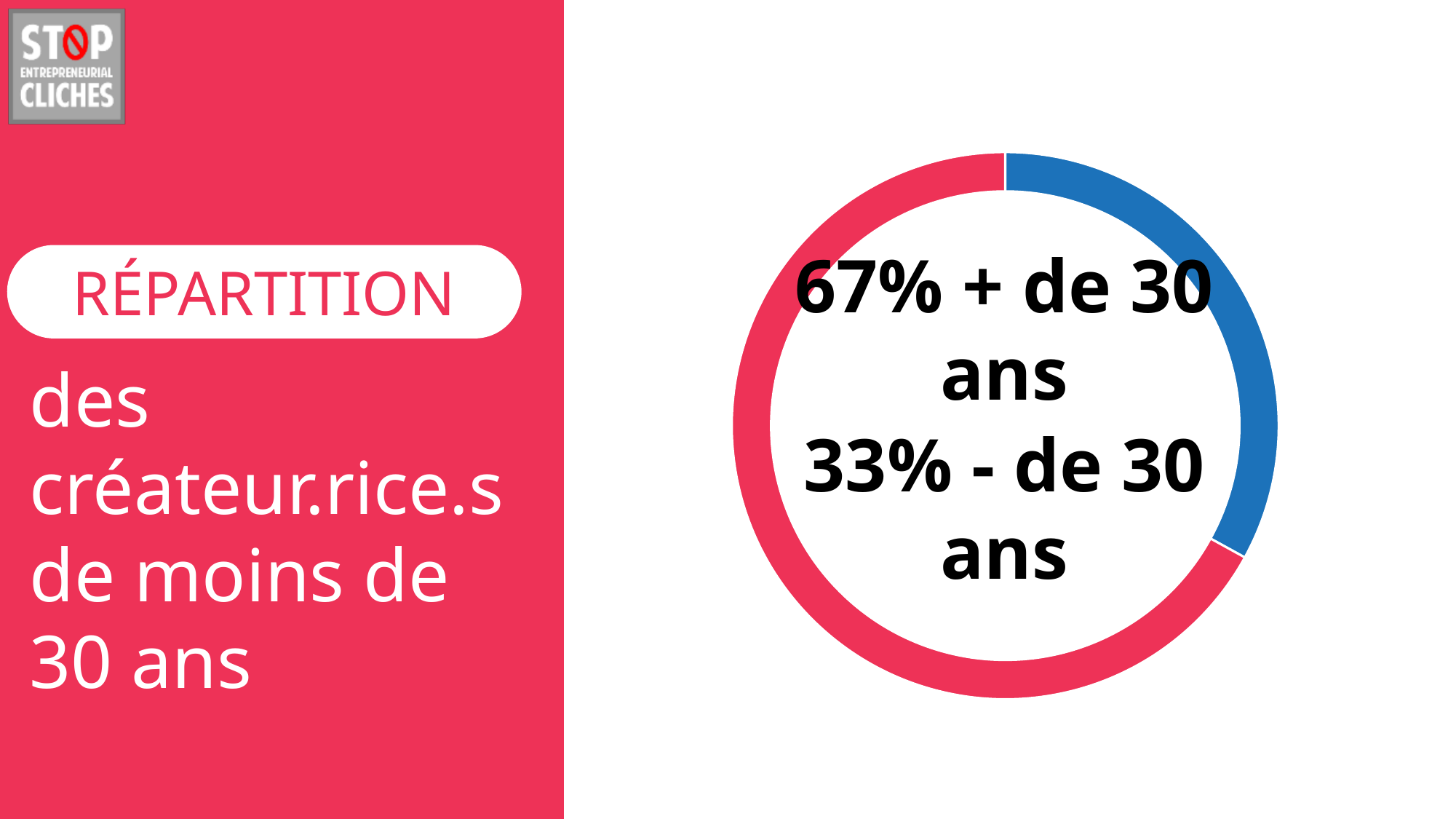
How many segments does the doughnut chart have? 2 What share of the doughnut chart corresponds to '- de 30 ans'? 33% What colour is the segment representing '- de 30 ans' in the doughnut chart? Blue What is the difference in percentage points between the '+ de 30 ans' and '- de 30 ans' shares? 34 What colour is the larger segment of the doughnut chart? Red Is the share for '+ de 30 ans' greater or less than 50%? greater What kind of chart is shown on the slide? Doughnut chart What do the two shares in the doughnut chart add up to? 100% Which category has the smallest share in the doughnut chart? - de 30 ans Which category has the largest share in the doughnut chart? + de 30 ans What share of the doughnut chart corresponds to '+ de 30 ans'? 67% Which is larger: the share for '+ de 30 ans' or the share for '- de 30 ans'? + de 30 ans